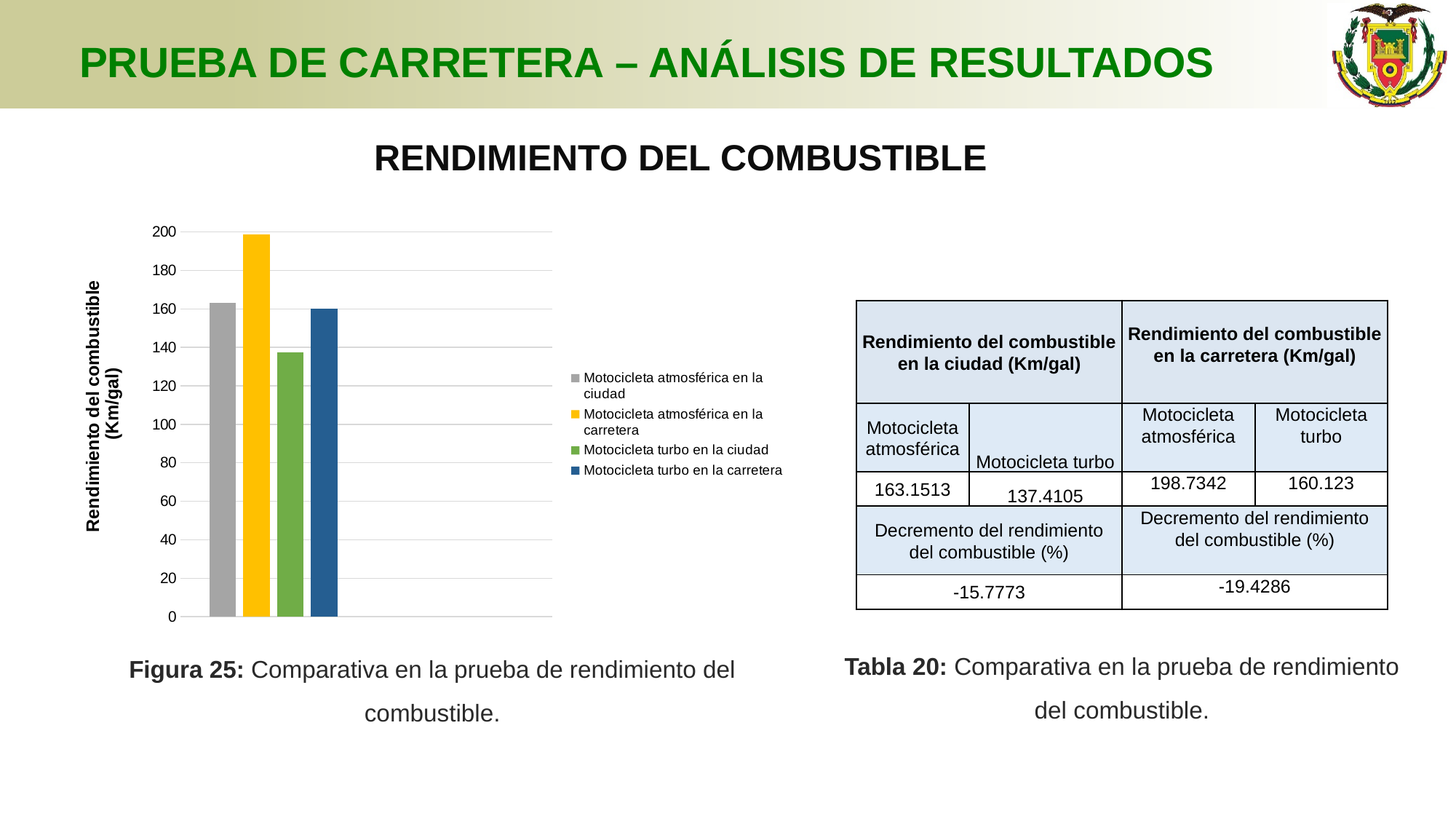
How many series does the legend of the chart list? 4 Which series has the lowest bar in the chart? Motocicleta turbo en la ciudad What is the label of the vertical axis of the chart? Rendimiento del combustible (Km/gal) Is the value for Motocicleta atmosférica en la ciudad greater or less than 140? greater Is the value for Motocicleta turbo en la ciudad greater or less than 120? greater Which is larger in the chart: Motocicleta atmosférica en la carretera or Motocicleta turbo en la carretera? Motocicleta atmosférica en la carretera Which series has the highest bar in the chart? Motocicleta atmosférica en la carretera How many bars are plotted in the chart? 4 Is the value for Motocicleta atmosférica en la carretera greater or less than 180? greater What kind of chart is shown in Figura 25? bar chart What colour is the bar for Motocicleta atmosférica en la carretera? yellow